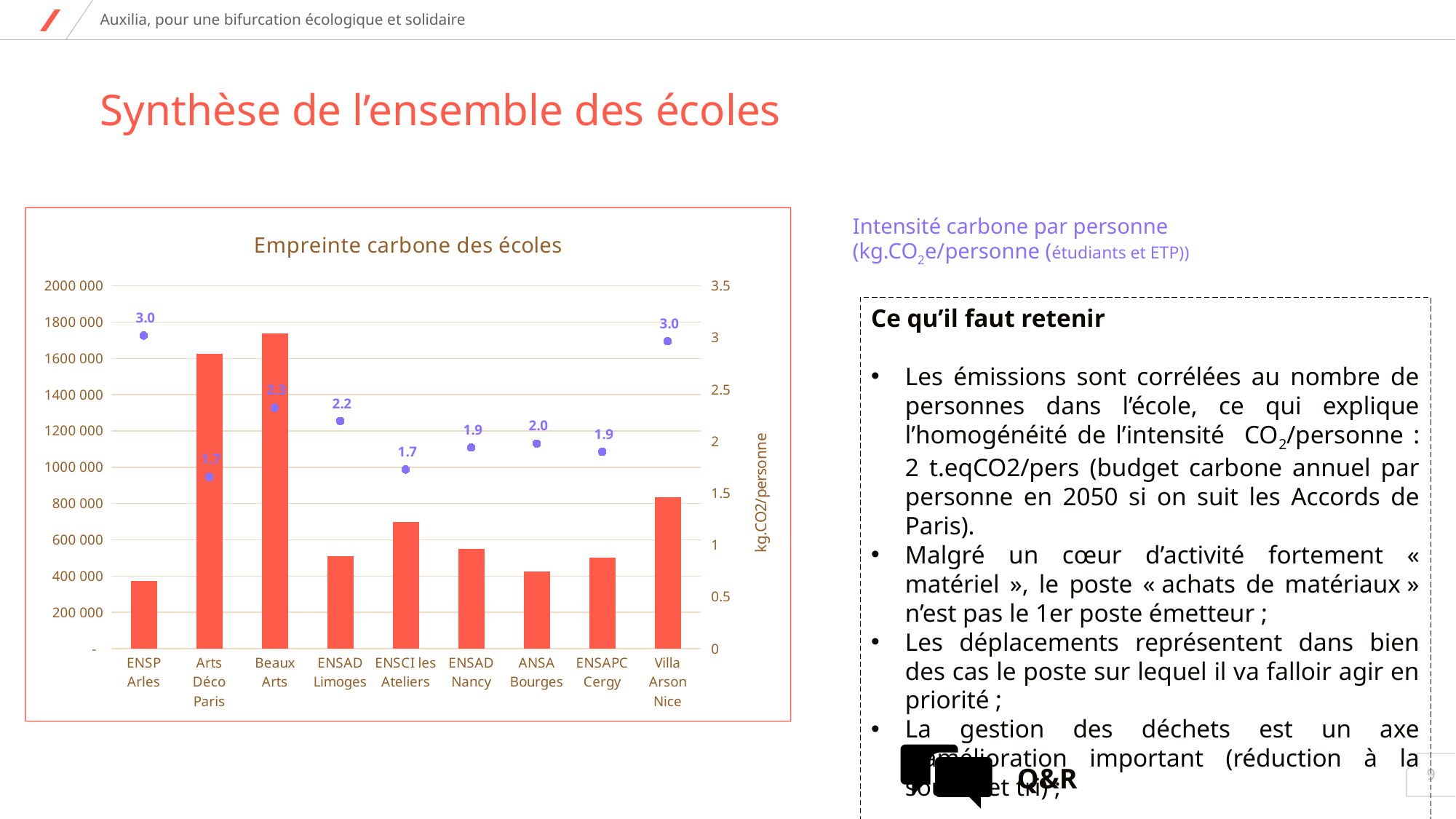
How many schools are shown on the x axis of the chart? 9 Is the bar value for Arts Déco Paris greater or less than 1400 000? greater What is the title of the chart on the slide? Empreinte carbone des écoles Which school has the tallest bar in the chart? Beaux Arts What is the labelled value of the point for ENSCI les Ateliers? 1.7 Which has a higher labelled point value, ENSAD Limoges or ENSAD Nancy? ENSAD Limoges What is the labelled value of the point for ANSA Bourges? 2.0 What is the labelled value of the point for Beaux Arts? 2.3 What is the labelled value of the point for ENSP Arles? 3.0 What is the difference between the labelled point values for Villa Arson Nice and ENSAPC Cergy? 1.1 What is the label of the right-hand vertical axis of the chart? kg.CO2/personne Is the bar value for ANSA Bourges greater or less than 600 000? less